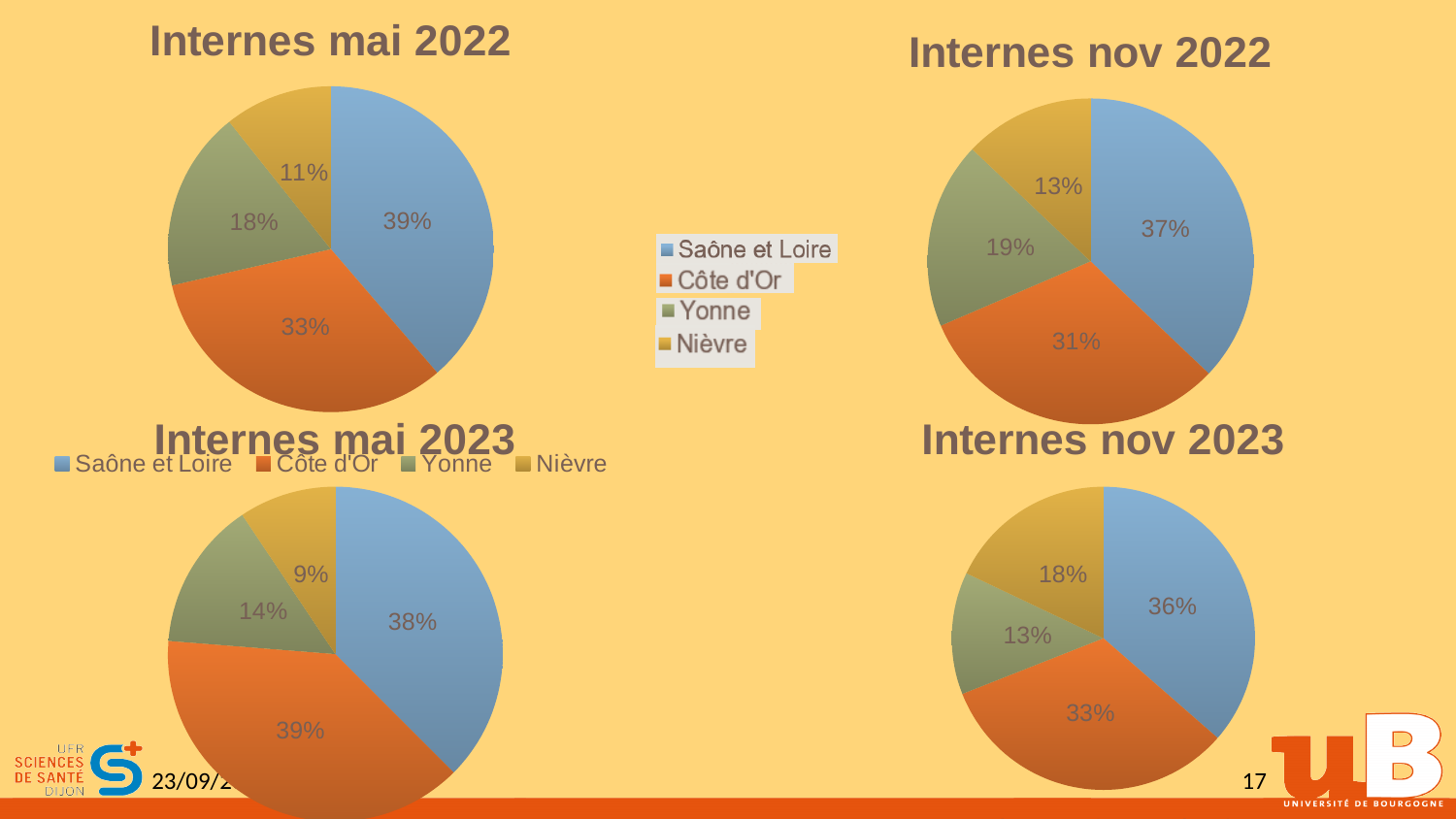
What kind of chart is 'Internes nov 2023'? Pie chart In the 'Internes mai 2022' chart, what share does Saône et Loire have? 39% How many slices does the 'Internes mai 2023' chart have? 4 In the 'Internes nov 2022' chart, which category has the largest slice? Saône et Loire In the 'Internes mai 2022' chart, which category has the smallest slice? Nièvre In the 'Internes nov 2023' chart, what share does Côte d'Or have? 33% In the 'Internes nov 2022' chart, what share does Yonne have? 19% In the 'Internes nov 2023' chart, which is larger, the Yonne slice or the Nièvre slice? Nièvre In the 'Internes nov 2022' chart, what is the difference between the Yonne share and the Nièvre share? 6% In the 'Internes mai 2023' chart, what share does Nièvre have? 9% How many entries does the legend in the centre of the slide list? 4 In the 'Internes mai 2022' chart, what is the difference between the Saône et Loire share and the Côte d'Or share? 6%